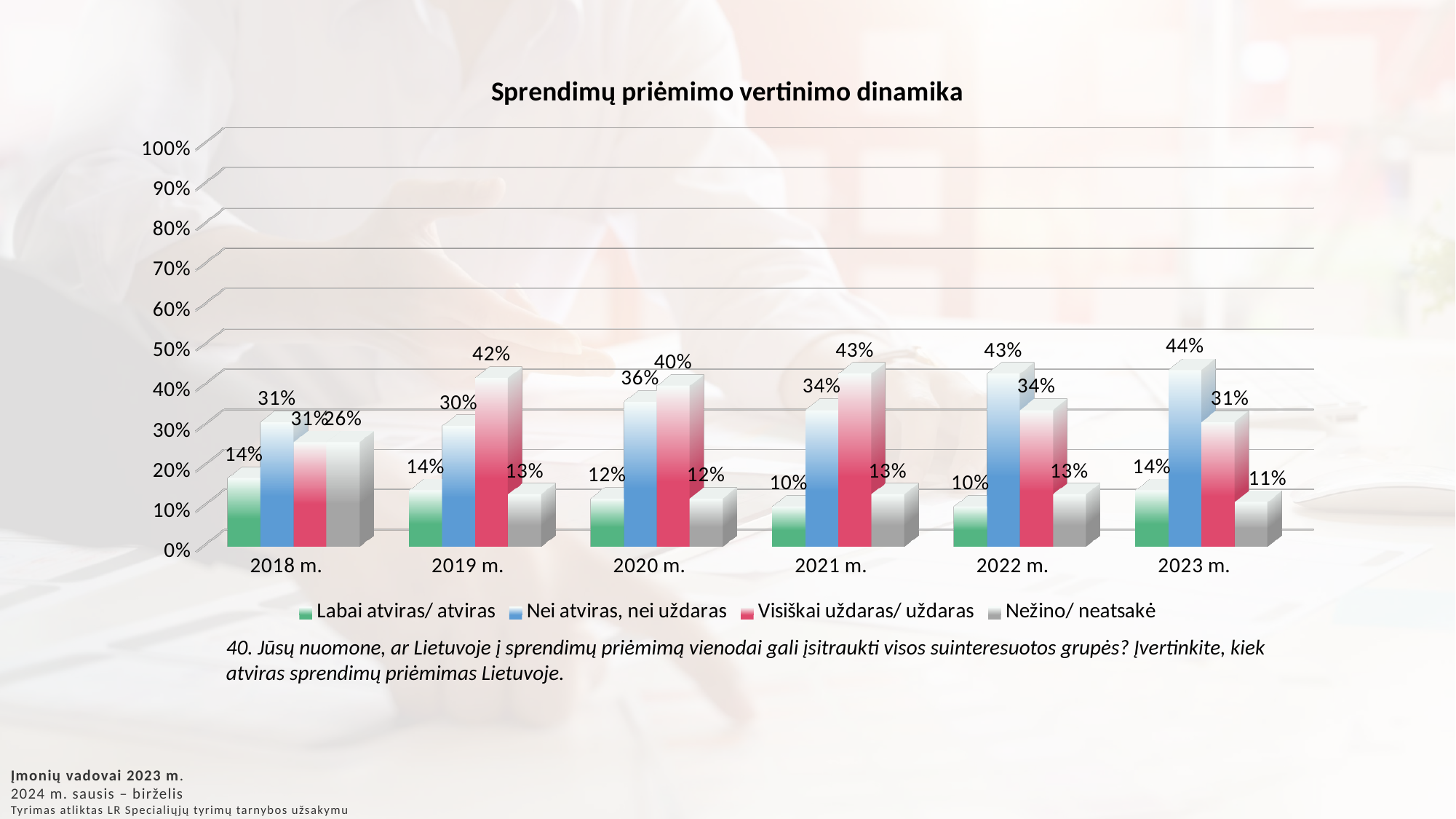
What is the difference between the 'Visiškai uždaras/ uždaras' value in 2021 m. and in 2023 m.? 12% How many years are shown on the x axis? 6 What is the value for 'Nei atviras, nei uždaras' in 2023 m.? 44% What is the value for 'Visiškai uždaras/ uždaras' in 2019 m.? 42% In which year is the 'Nežino/ neatsakė' value lowest? 2023 m. What is the value for 'Nežino/ neatsakė' in 2018 m.? 26% What is the title of the chart? Sprendimų priėmimo vertinimo dinamika How many series does the legend list? 4 In which year is the 'Nei atviras, nei uždaras' value highest? 2023 m. What is the value for 'Labai atviras/ atviras' in 2021 m.? 10% What type of chart is shown on the slide? bar chart In 2022 m., which is larger: 'Nei atviras, nei uždaras' or 'Visiškai uždaras/ uždaras'? Nei atviras, nei uždaras